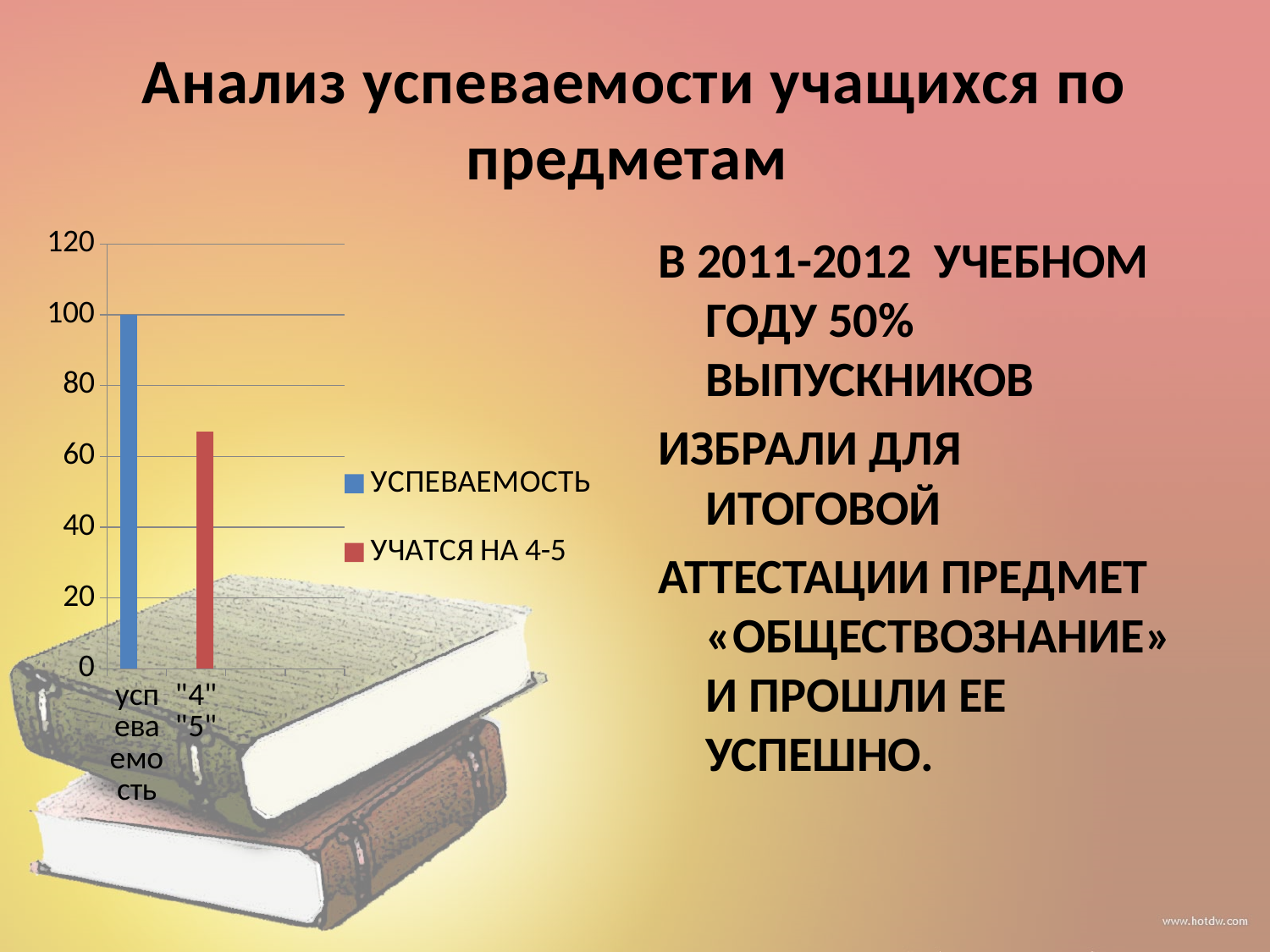
Which series has the highest bar? УСПЕВАЕМОСТЬ What kind of chart is shown on the slide? bar chart What is the highest value shown on the vertical axis? 120 Which is larger, the УСПЕВАЕМОСТЬ bar or the УЧАТСЯ НА 4-5 bar? УСПЕВАЕМОСТЬ What is the value of the УСПЕВАЕМОСТЬ bar? 100 Is the value for УЧАТСЯ НА 4-5 greater or less than 80? less How many series does the chart legend list? 2 Is the value for УЧАТСЯ НА 4-5 greater or less than 60? greater What colour is the УСПЕВАЕМОСТЬ bar? blue How many bars are plotted in the chart? 2 Which series has the lowest bar? УЧАТСЯ НА 4-5